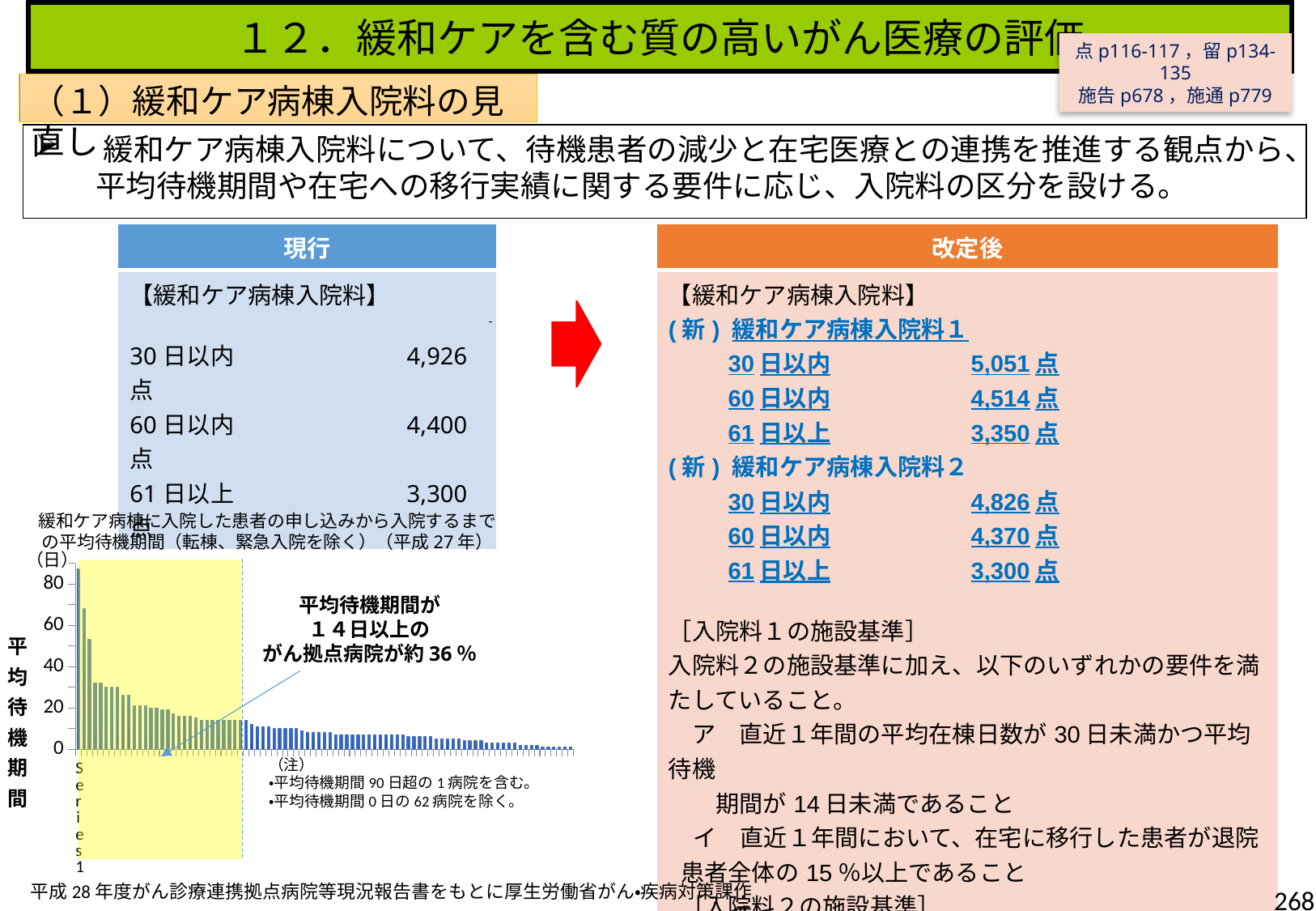
Is the value of the tallest bar in the chart greater or less than 60? greater What kind of chart is shown at the bottom left of the slide? bar chart What is the highest tick value shown on the chart's y axis? 80 Is the value of the second bar from the left in the chart greater or less than 40? greater According to the annotation on the chart, what share of cancer hub hospitals have an average waiting period of 14 days or more? 約36％ Is the value of the rightmost bar in the chart greater or less than 20? less Do the bar values in the chart rise or fall from left to right along the x axis? fall